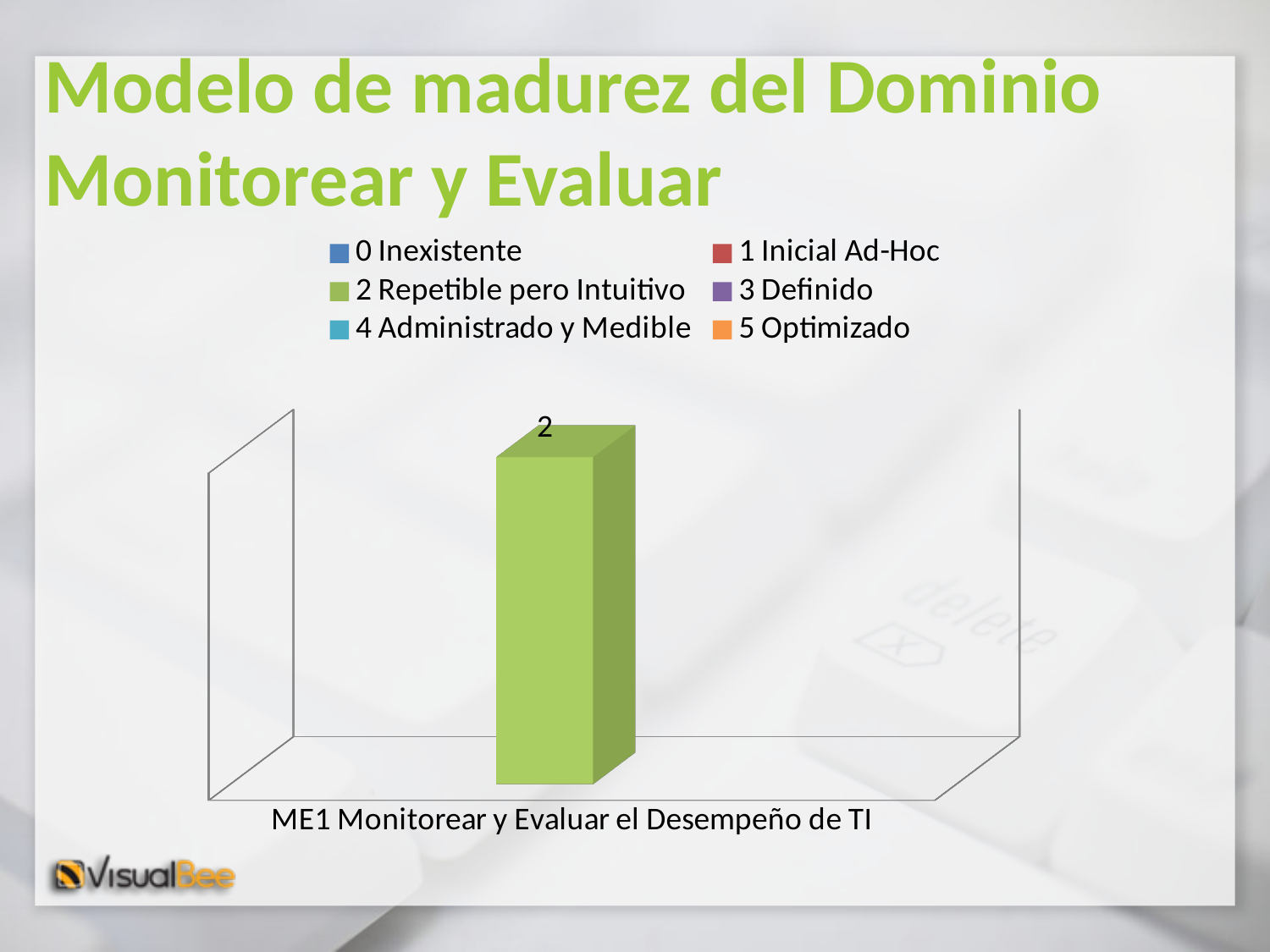
What is the value shown for ME1 Monitorear y Evaluar el Desempeño de TI? 2 How many bars are visible in the chart? 1 Which legend entry does the green bar correspond to? 2 Repetible pero Intuitivo What kind of chart is shown on the slide? bar chart How many categories are plotted on the x axis of the chart? 1 What is the label of the category shown on the x axis? ME1 Monitorear y Evaluar el Desempeño de TI How many series does the chart legend list? 6 What is the data label printed above the bar in the chart? 2